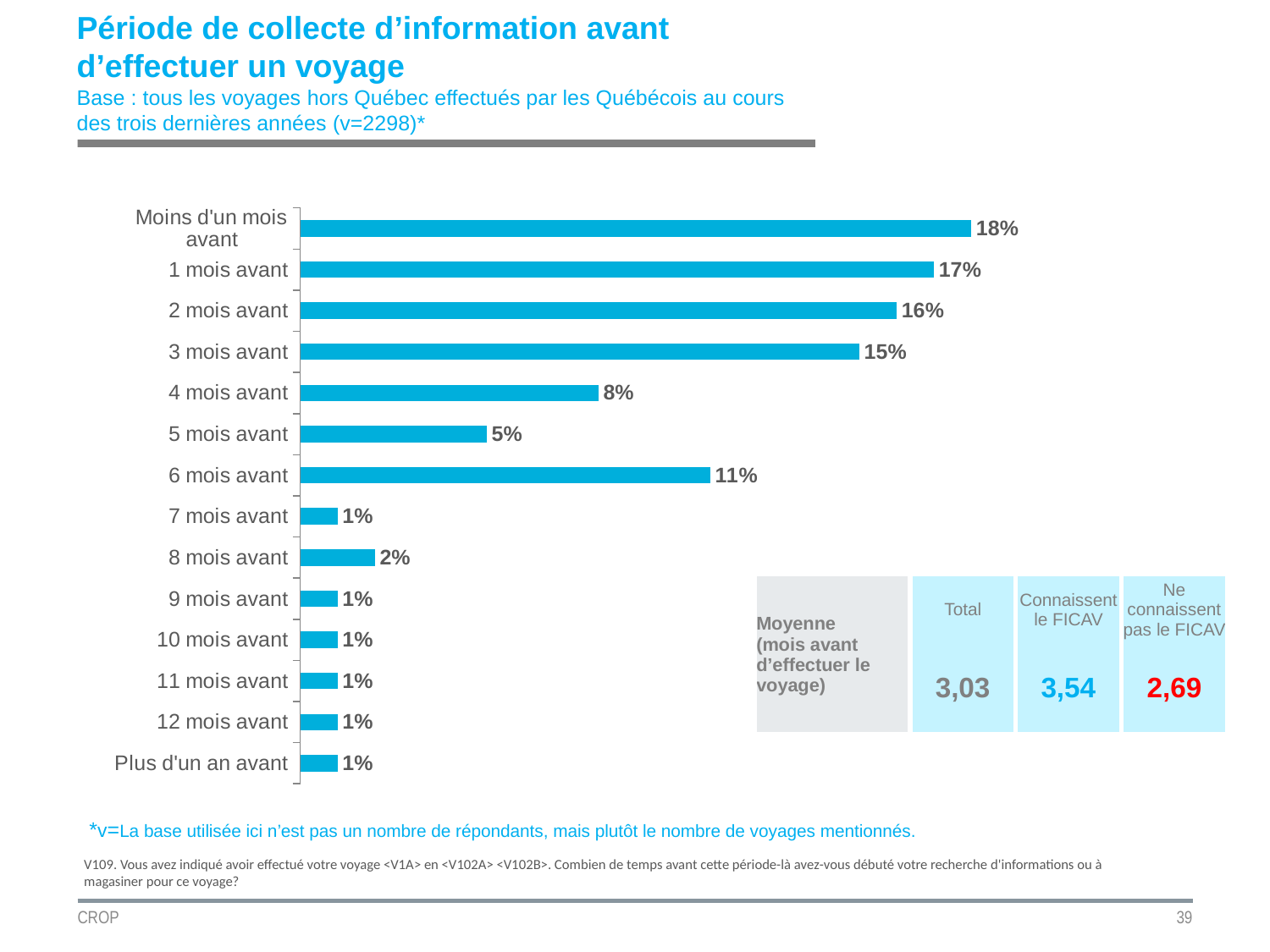
What is the value for "Moins d'un mois avant"? 18% What is the value for "6 mois avant"? 11% What kind of chart is shown on the slide? Bar chart What is the value for "4 mois avant"? 8% What is the value for "8 mois avant"? 2% What is the value for "Plus d'un an avant"? 1% What is the difference between the values for "1 mois avant" and "5 mois avant"? 12% Which is larger, the value for "5 mois avant" or the value for "6 mois avant"? 6 mois avant Which is larger, the value for "2 mois avant" or the value for "4 mois avant"? 2 mois avant How many categories are shown in the chart? 14 Which category has the highest value? Moins d'un mois avant What is the difference between the values for "3 mois avant" and "6 mois avant"? 4%